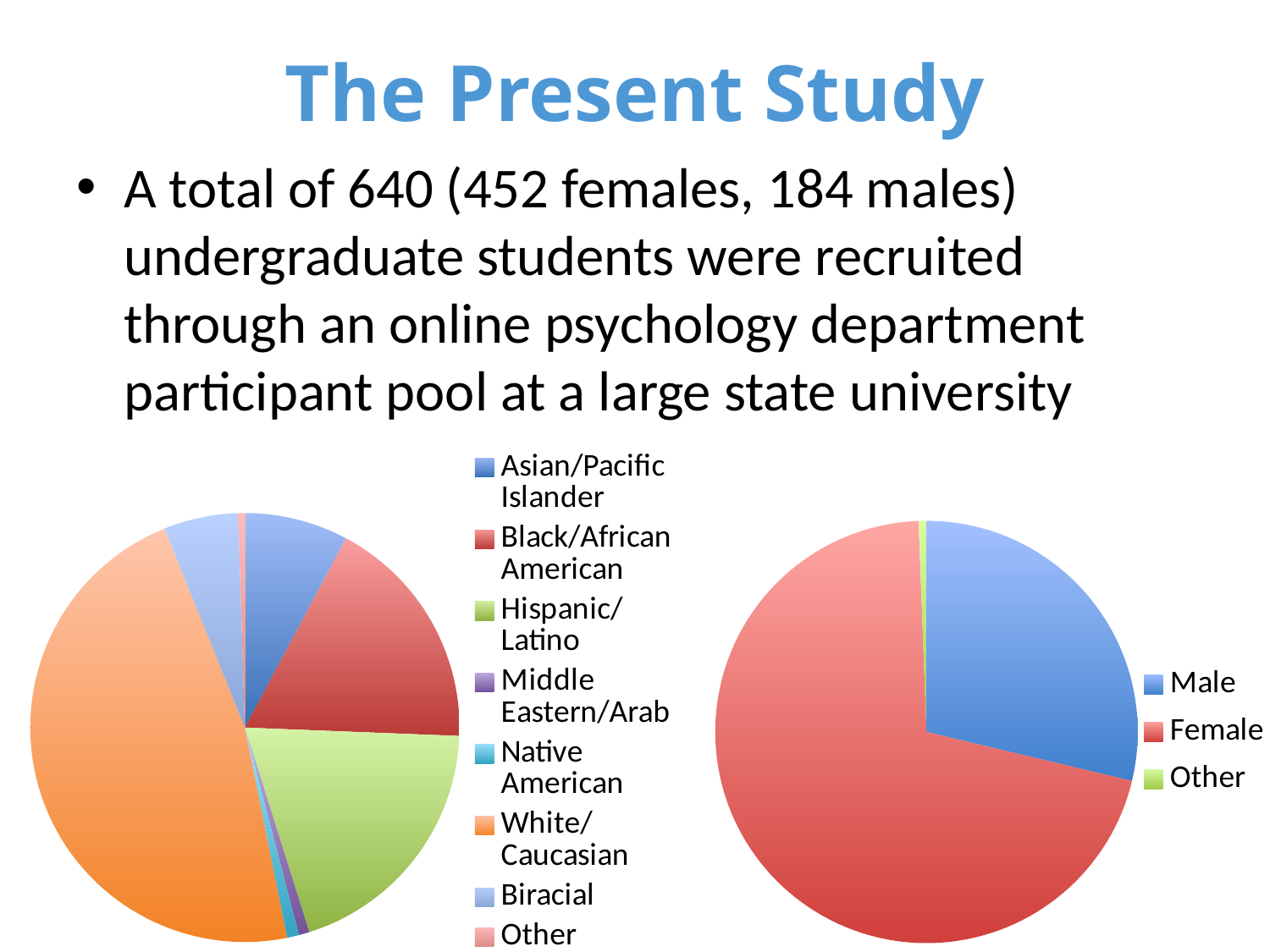
In the right pie chart, what colour is the Female slice? red What kind of chart is the left chart on the slide? pie chart In the left pie chart, which slice is larger: Hispanic/Latino or Biracial? Hispanic/Latino In the left pie chart, which slice is larger: Black/African American or Asian/Pacific Islander? Black/African American In the left pie chart, which category has the largest slice? White/Caucasian What kind of chart is the right chart on the slide? pie chart How many categories does the legend of the left pie chart list? 8 In the right pie chart, which category has the smallest slice? Other In the right pie chart, which slice is larger: Male or Female? Female How many categories does the legend of the right pie chart list? 3 In the right pie chart, which category has the largest slice? Female In the left pie chart, what colour is the White/Caucasian slice? orange